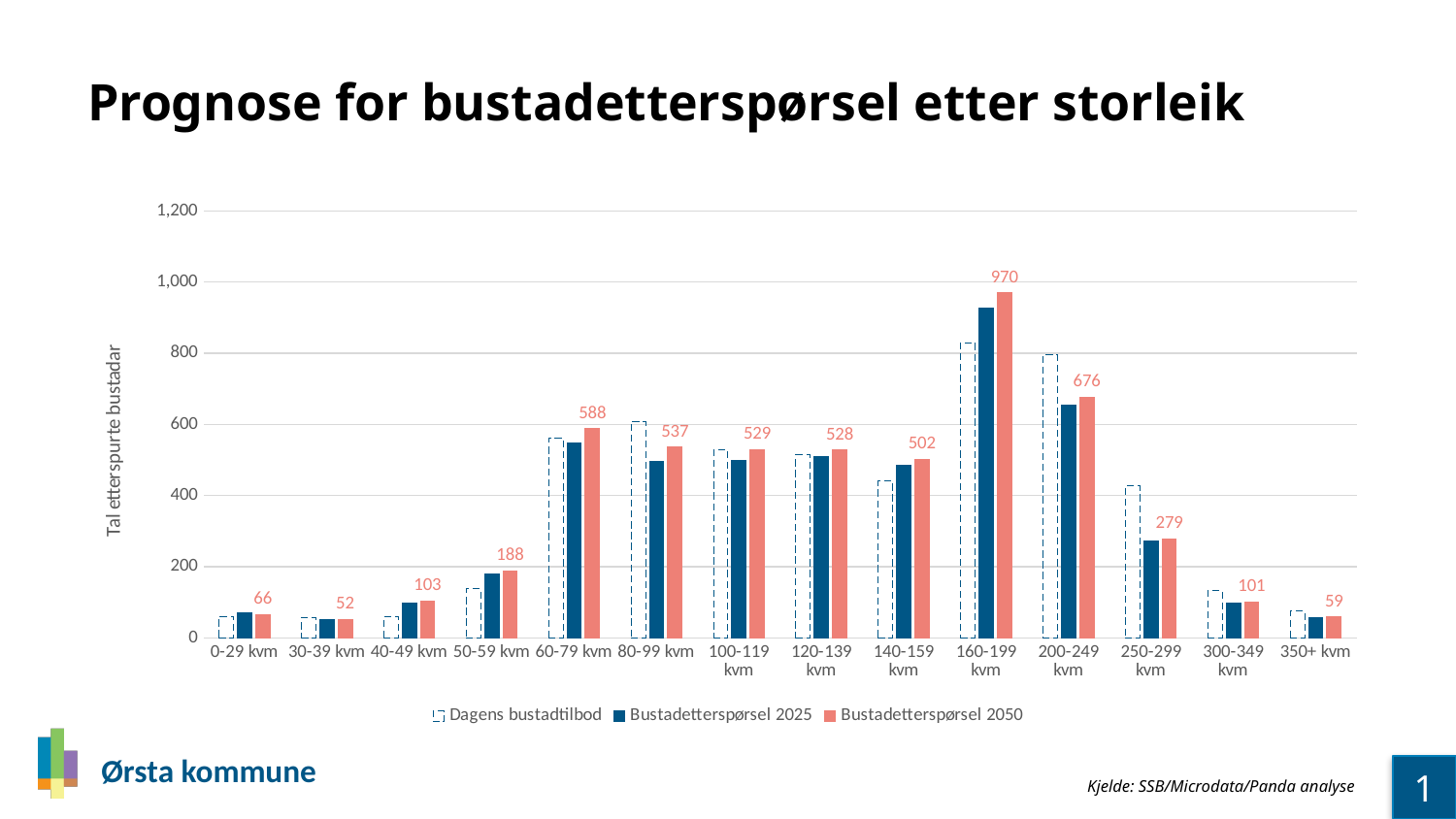
What is the Bustadetterspørsel 2050 value for the 160-199 kvm category? 970 What is the difference between the Bustadetterspørsel 2050 values for 160-199 kvm and 200-249 kvm? 294 Which category has the larger Bustadetterspørsel 2050 value, 60-79 kvm or 80-99 kvm? 60-79 kvm What is the Bustadetterspørsel 2050 value for the 250-299 kvm category? 279 Is the Bustadetterspørsel 2025 value for 250-299 kvm greater or less than 400? less What kind of chart is shown on the slide? Bar chart Is the Dagens bustadtilbod value for 200-249 kvm greater or less than 600? greater What is the Bustadetterspørsel 2050 value for the 50-59 kvm category? 188 Which category has the lowest Bustadetterspørsel 2050 value? 30-39 kvm How many size categories are shown on the x axis? 14 Which category has the highest Bustadetterspørsel 2050 value? 160-199 kvm How many series does the legend list? 3